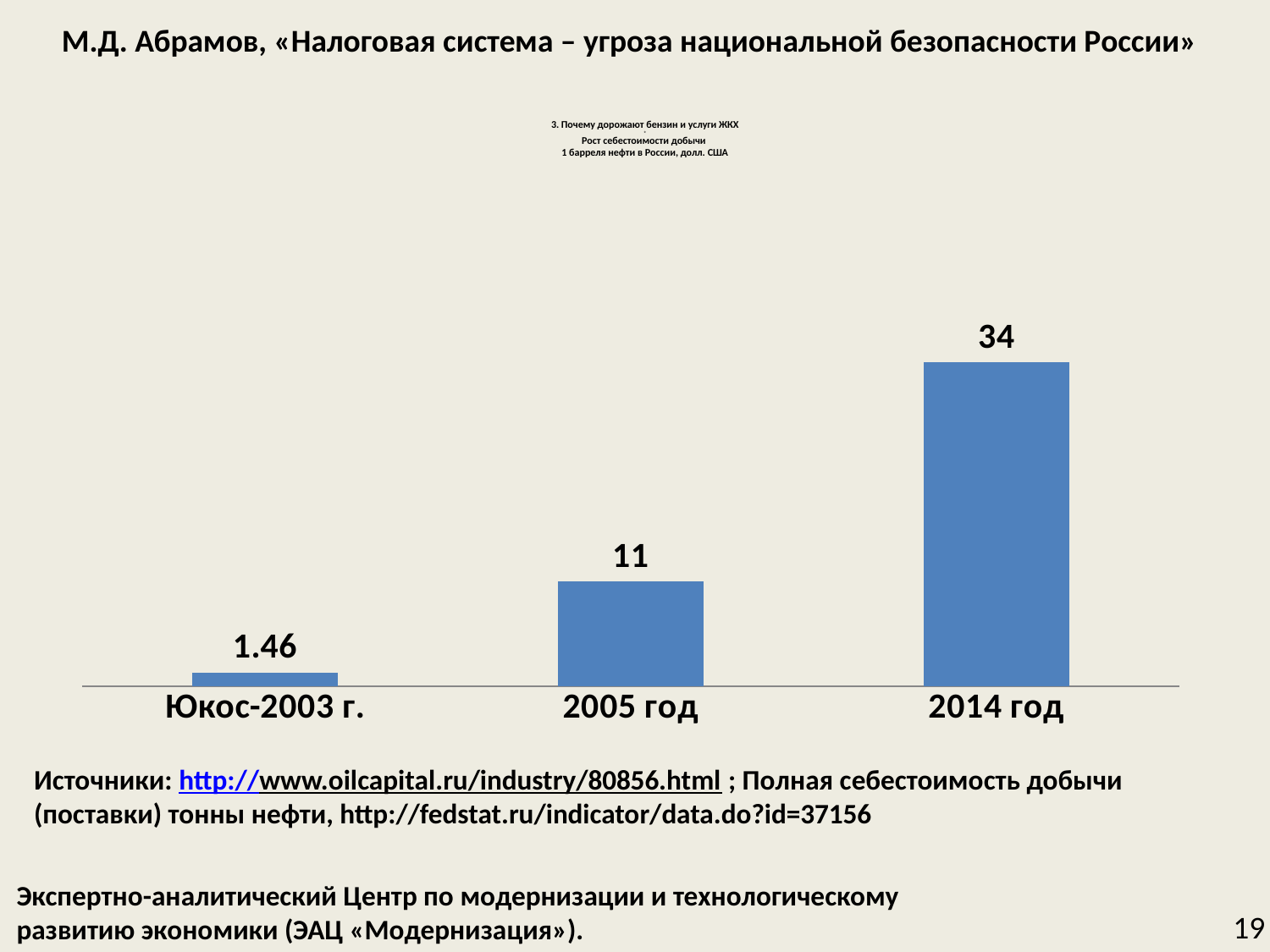
Which category has the highest value? 2014 год What is the difference between the values for 2005 год and Юкос-2003 г.? 9.54 Which category has the lowest value? Юкос-2003 г. What is the value for 2014 год? 34 What is the value for 2005 год? 11 What is the value for Юкос-2003 г.? 1.46 How many categories are shown on the chart? 3 Do the values rise or fall from left to right along the x axis? rise Which is larger, the value for 2005 год or the value for Юкос-2003 г.? 2005 год What colour are the bars in the chart? blue What kind of chart is shown on the slide? bar chart What is the difference between the values for 2014 год and 2005 год? 23